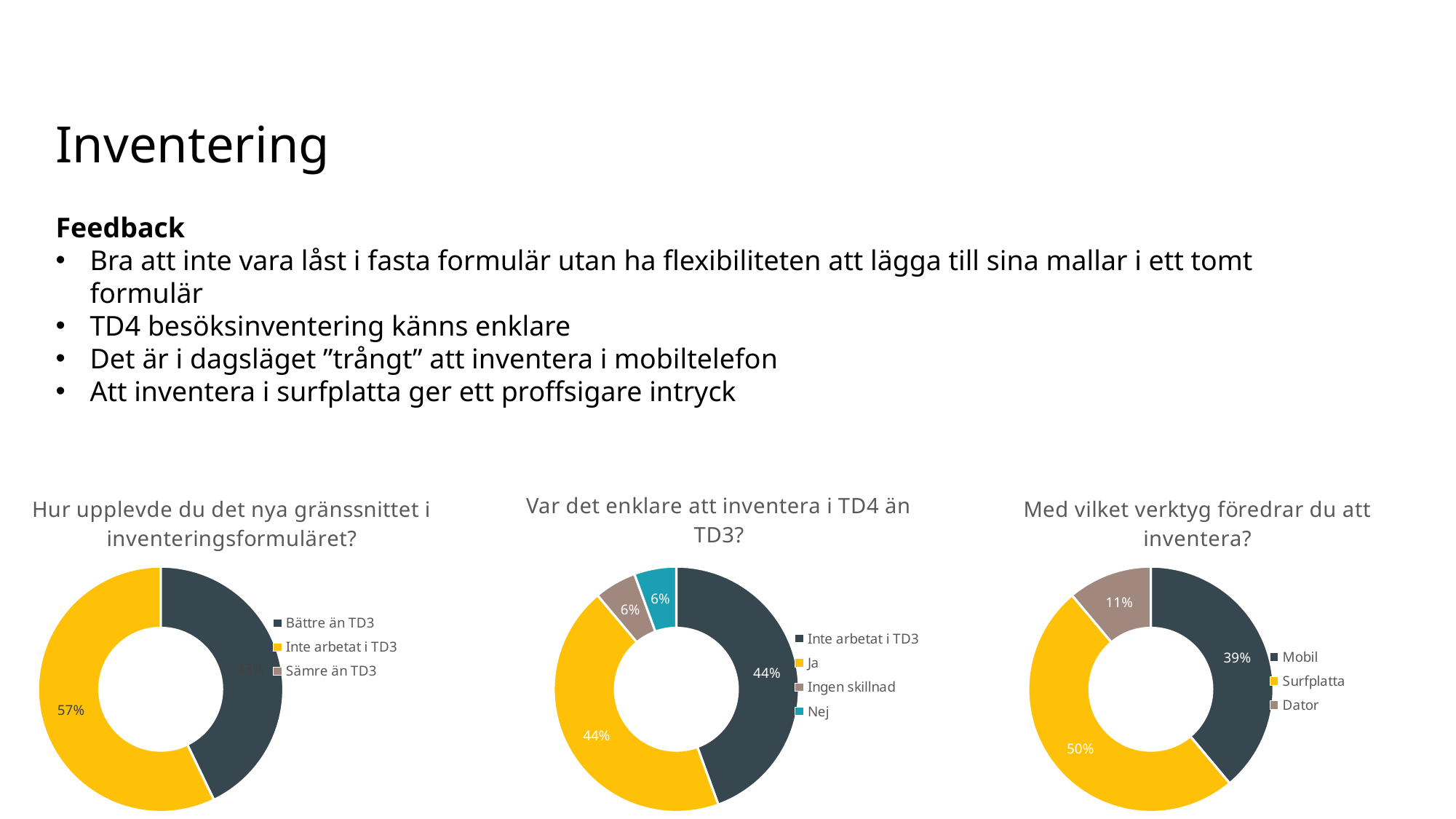
In the chart titled "Var det enklare att inventera i TD4 än TD3?", how many entries does the legend list? 4 In the chart titled "Var det enklare att inventera i TD4 än TD3?", what share does Nej have? 6% In the chart titled "Var det enklare att inventera i TD4 än TD3?", which is larger, Ja or Ingen skillnad? Ja In the chart titled "Hur upplevde du det nya gränssnittet i inventeringsformuläret?", which is larger, Inte arbetat i TD3 or Bättre än TD3? Inte arbetat i TD3 In the chart titled "Hur upplevde du det nya gränssnittet i inventeringsformuläret?", what share does Inte arbetat i TD3 have? 57% In the chart titled "Med vilket verktyg föredrar du att inventera?", what share does Surfplatta have? 50% In the chart titled "Med vilket verktyg föredrar du att inventera?", which category has the largest share? Surfplatta In the chart titled "Med vilket verktyg föredrar du att inventera?", which category has the smallest share? Dator What kind of chart is the chart titled "Med vilket verktyg föredrar du att inventera?"? Doughnut (pie) chart In the chart titled "Var det enklare att inventera i TD4 än TD3?", what share does Ja have? 44% In the chart titled "Med vilket verktyg föredrar du att inventera?", what share does Mobil have? 39% In the chart titled "Med vilket verktyg föredrar du att inventera?", what is the difference in percentage points between Surfplatta and Mobil? 11